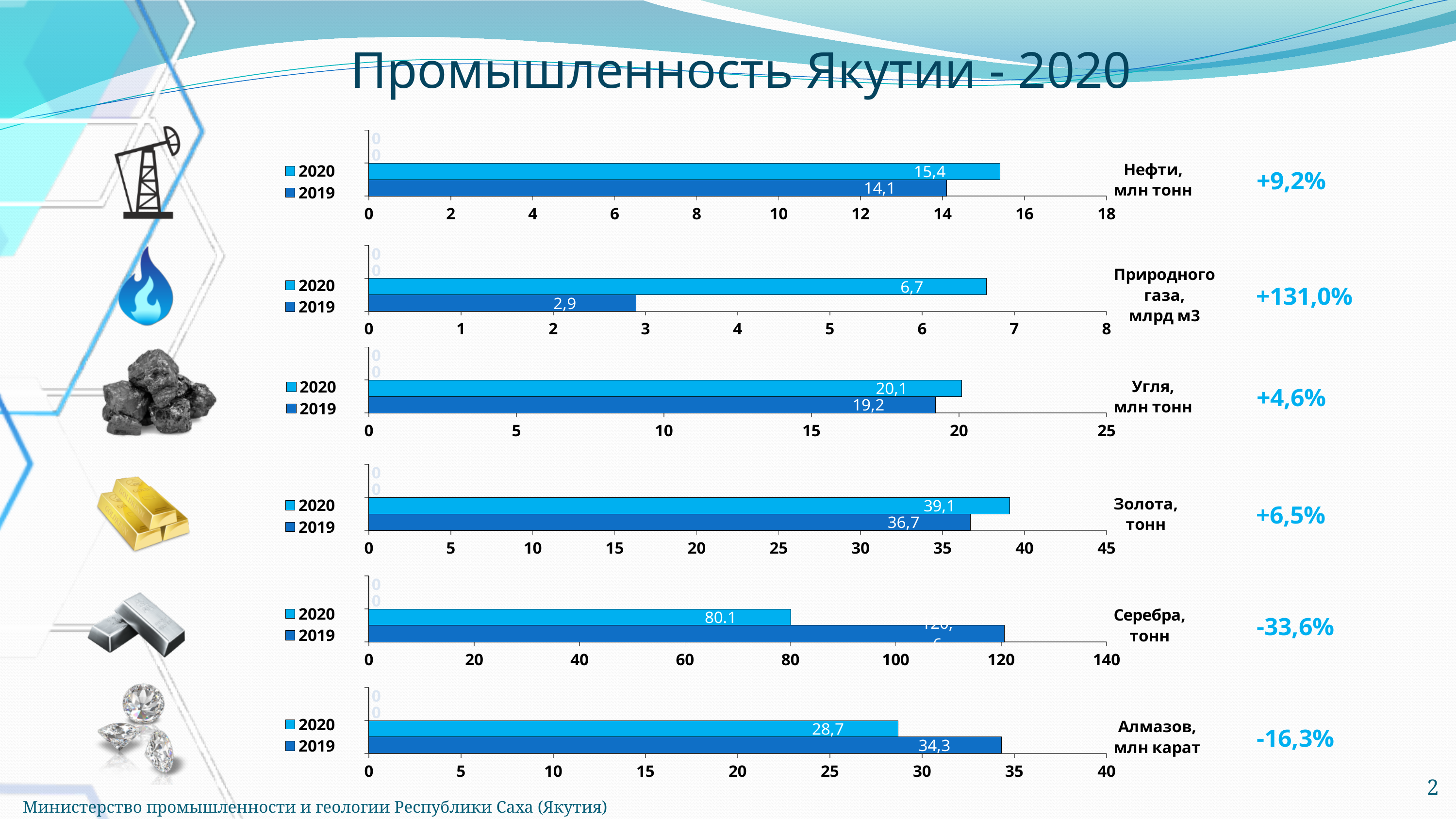
In the coal chart (Угля, млн тонн), which year has the higher value, 2020 or 2019? 2020 In the natural gas chart (Природного газа, млрд м3), what is the value for 2019? 2,9 In the diamonds chart (Алмазов, млн карат), which year has the lower value, 2020 or 2019? 2020 In the gold chart (Золота, тонн), what is the difference between the 2020 and 2019 values? 2,4 What kind of chart is used for the diamonds data (Алмазов, млн карат)? bar chart In the oil chart (Нефти, млн тонн), what is the value for 2019? 14,1 In the gold chart (Золота, тонн), what is the value for 2020? 39,1 How many series does the legend of each chart list? 2 In the natural gas chart (Природного газа, млрд м3), what is the difference between the 2020 and 2019 values? 3,8 In the oil chart (Нефти, млн тонн), what is the value for 2020? 15,4 In the silver chart (Серебра, тонн), what is the value for 2020? 80.1 In the silver chart (Серебра, тонн), is the value for 2019 greater or less than 100? greater